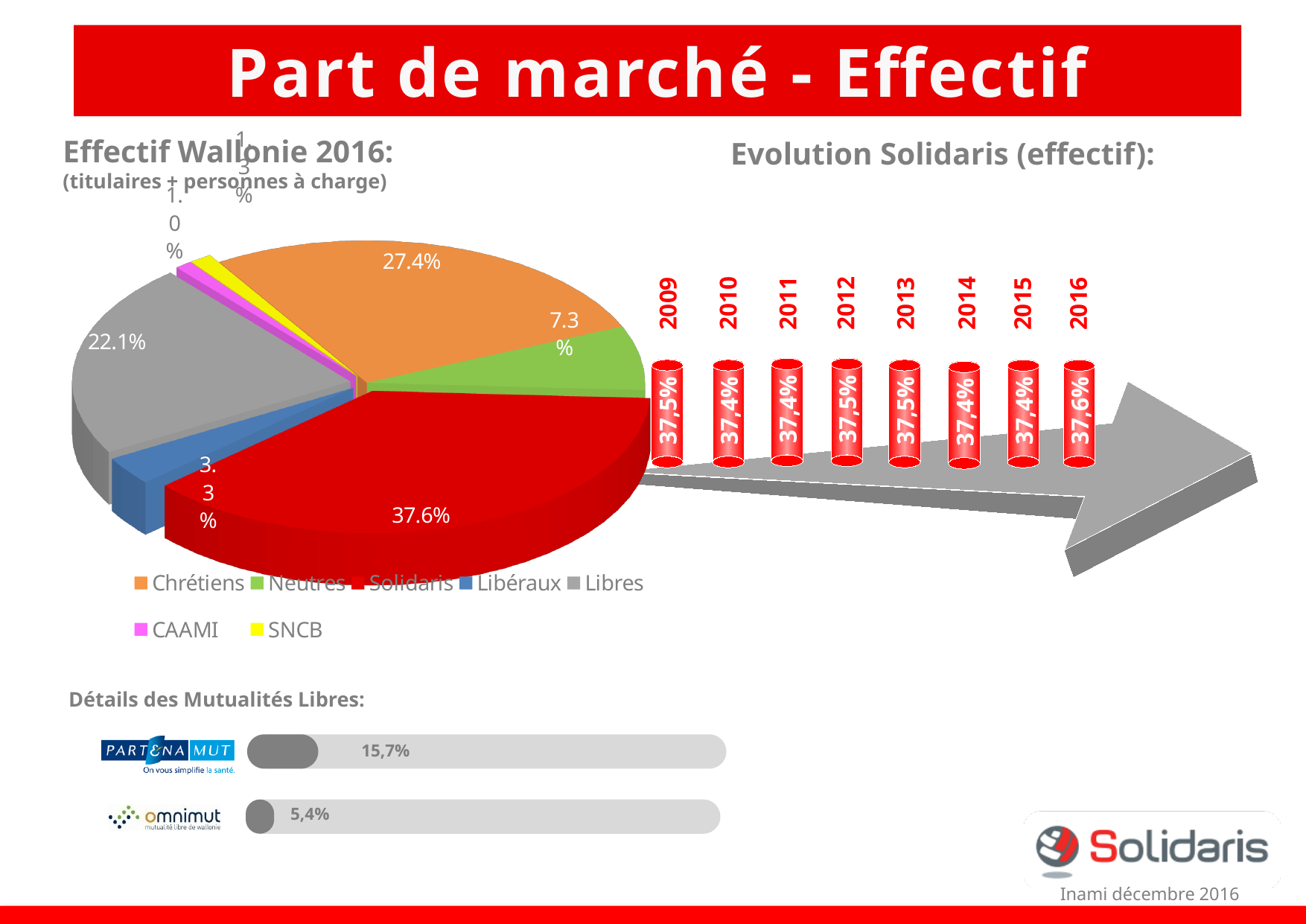
In the 'Effectif Wallonie 2016' pie chart, what share does Solidaris hold? 37.6% In the 'Effectif Wallonie 2016' pie chart, what is the value for Neutres? 7.3% In the 'Evolution Solidaris (effectif)' graphic, how many years are shown? 8 In the 'Effectif Wallonie 2016' pie chart, what is the value for Libres? 22.1% How many categories does the legend of the 'Effectif Wallonie 2016' pie chart list? 7 In the 'Effectif Wallonie 2016' pie chart, what is the value for Chrétiens? 27.4% In the 'Effectif Wallonie 2016' pie chart, what colour is the Solidaris slice? Red In the 'Evolution Solidaris (effectif)' graphic, what is the value shown for 2016? 37,6% What type of chart is 'Effectif Wallonie 2016'? Pie chart In the 'Effectif Wallonie 2016' pie chart, which category has the largest slice? Solidaris In the 'Effectif Wallonie 2016' pie chart, which is larger, Chrétiens or Libres? Chrétiens In the 'Effectif Wallonie 2016' pie chart, what is the difference between Solidaris and Chrétiens? 10.2%